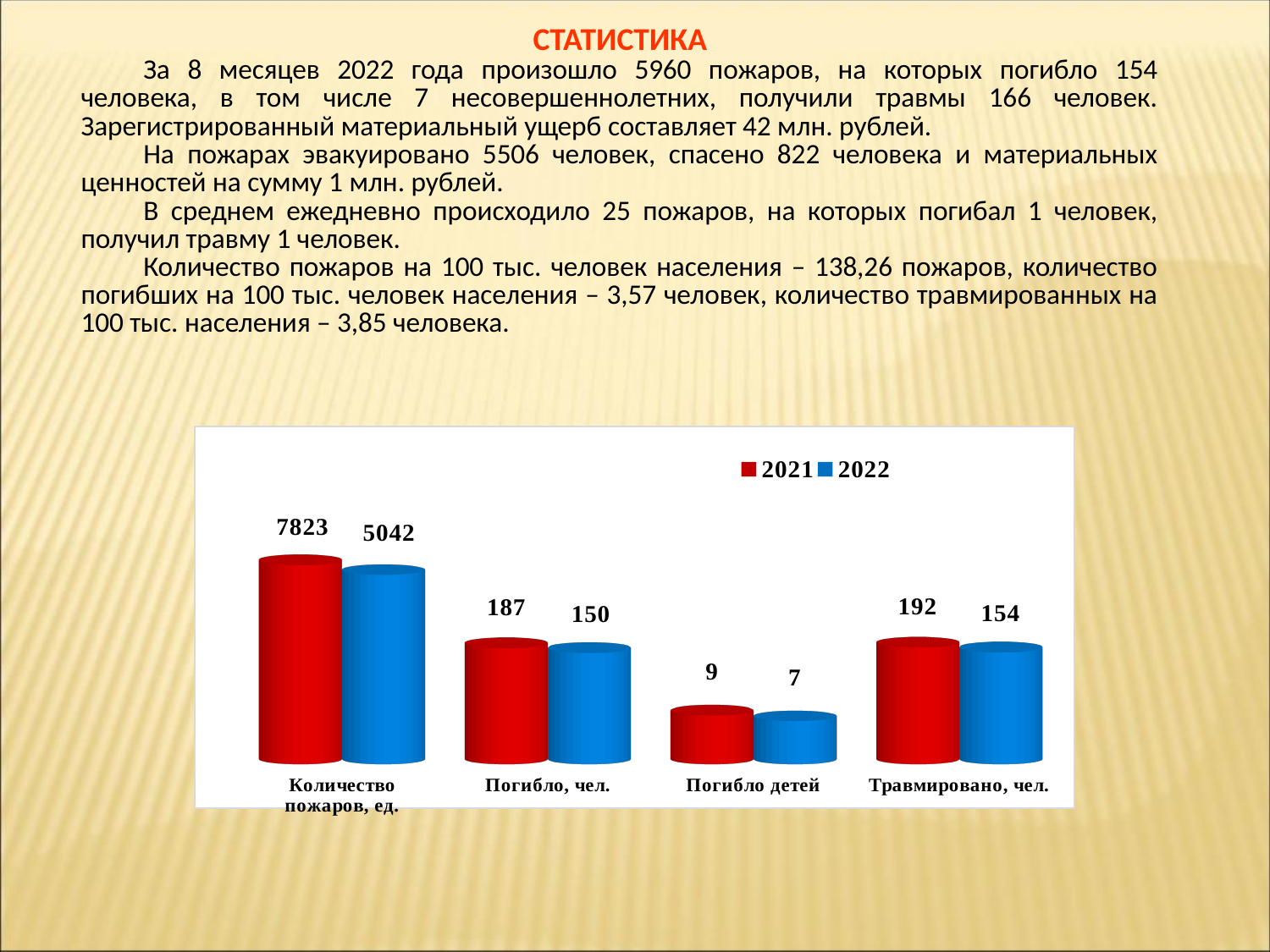
What is the value for 2021 in the "Количество пожаров, ед." category? 7823 What is the value for 2021 in the "Погибло детей" category? 9 Which category has the lowest value for the 2022 series? Погибло детей What is the value for 2022 in the "Погибло, чел." category? 150 How many series does the chart legend list? 2 What is the value for 2022 in the "Травмировано, чел." category? 154 What is the difference between the 2021 and 2022 values in the "Количество пожаров, ед." category? 2781 Which category has the highest value for the 2021 series? Количество пожаров, ед. What is the difference between the 2021 and 2022 values in the "Погибло, чел." category? 37 What is the value for 2022 in the "Количество пожаров, ед." category? 5042 How many categories are shown on the x axis of the chart? 4 In the "Травмировано, чел." category, which series has the larger value, 2021 or 2022? 2021